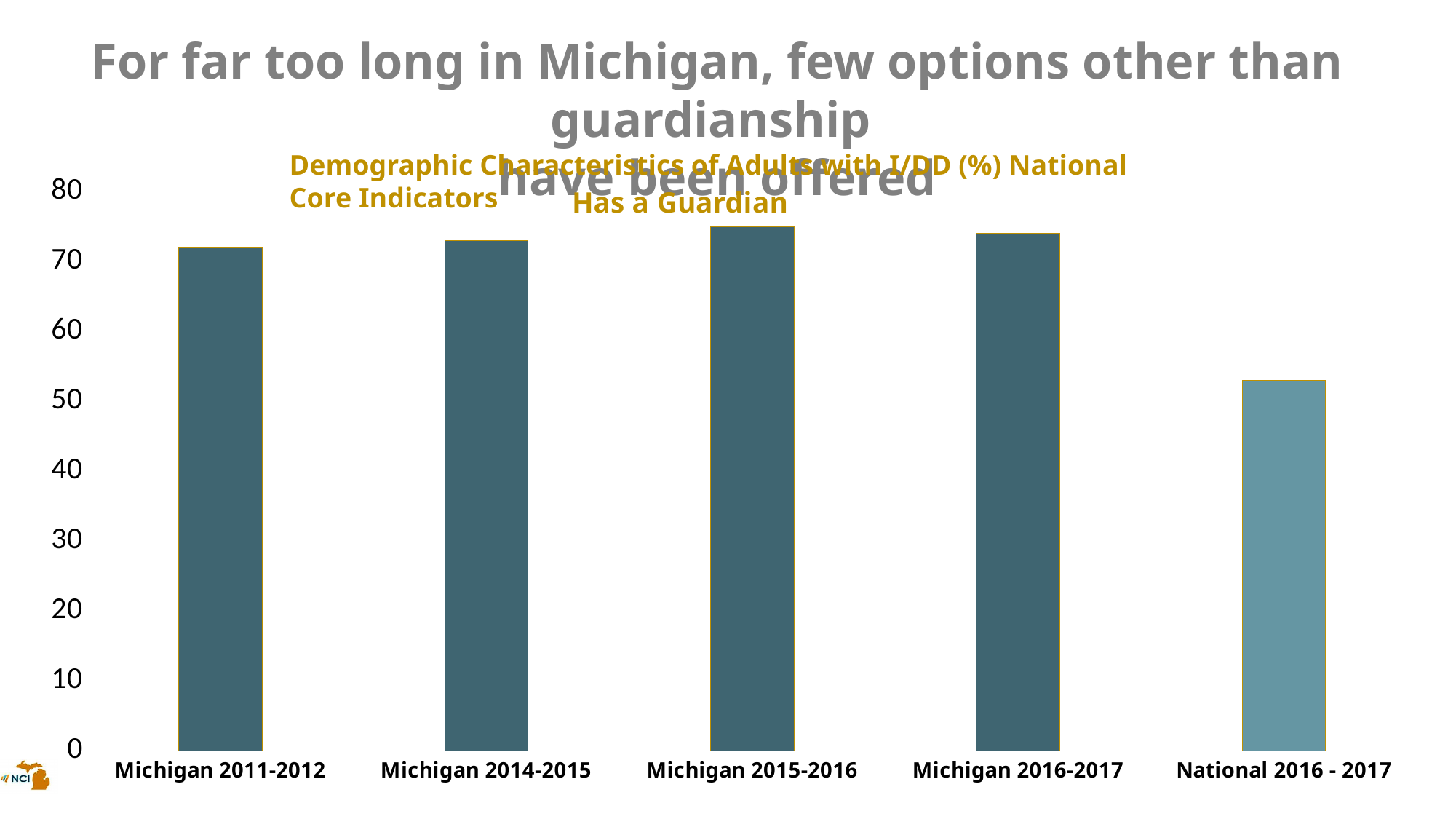
Is the value for National 2016 - 2017 greater or less than 60? less Which category has the lowest value in the chart? National 2016 - 2017 Do the Michigan values rise or fall from Michigan 2011-2012 to Michigan 2015-2016? rise What is the title of the chart (the label above the bars)? Has a Guardian Which bar is drawn in a lighter colour than the others? National 2016 - 2017 Is the value for National 2016 - 2017 greater or less than 50? greater Is the value for Michigan 2015-2016 greater or less than 80? less Which is larger, the value for Michigan 2011-2012 or the value for National 2016 - 2017? Michigan 2011-2012 What kind of chart is shown on the slide? Bar chart How many categories (bars) are shown in the chart? 5 Which is larger, the value for Michigan 2015-2016 or the value for National 2016 - 2017? Michigan 2015-2016